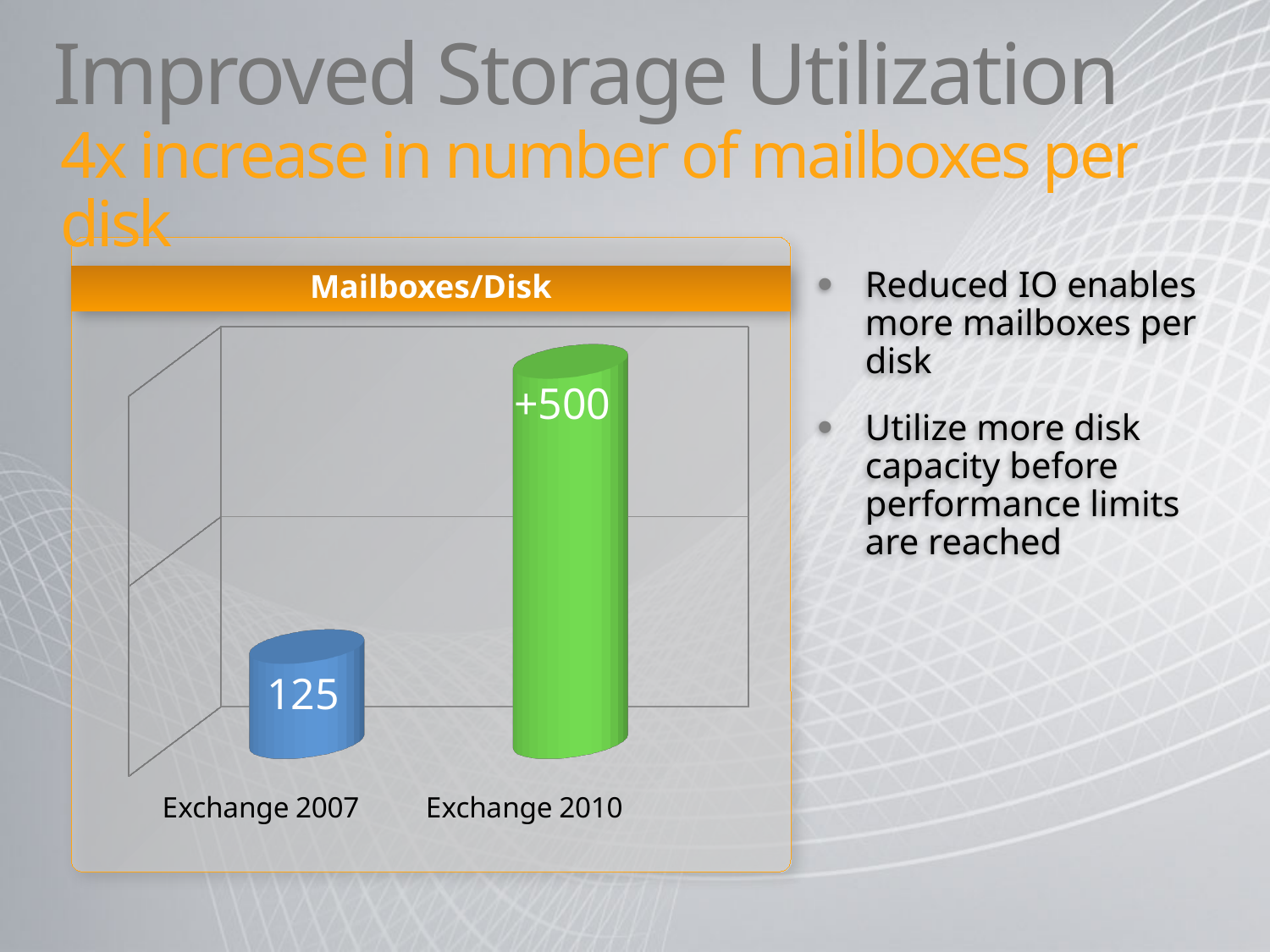
What colour is the Exchange 2010 bar in the Mailboxes/Disk chart? Green What is the title of the chart on the slide? Mailboxes/Disk How many categories are plotted in the Mailboxes/Disk chart? 2 Which category has the lowest value in the Mailboxes/Disk chart? Exchange 2007 What data label is shown on the Exchange 2010 bar in the Mailboxes/Disk chart? +500 Which is larger in the Mailboxes/Disk chart, Exchange 2007 or Exchange 2010? Exchange 2010 Do the values rise or fall from Exchange 2007 to Exchange 2010 in the Mailboxes/Disk chart? Rise What kind of chart is the Mailboxes/Disk chart? Bar chart Which category has the highest value in the Mailboxes/Disk chart? Exchange 2010 What is the value shown for Exchange 2007 in the Mailboxes/Disk chart? 125